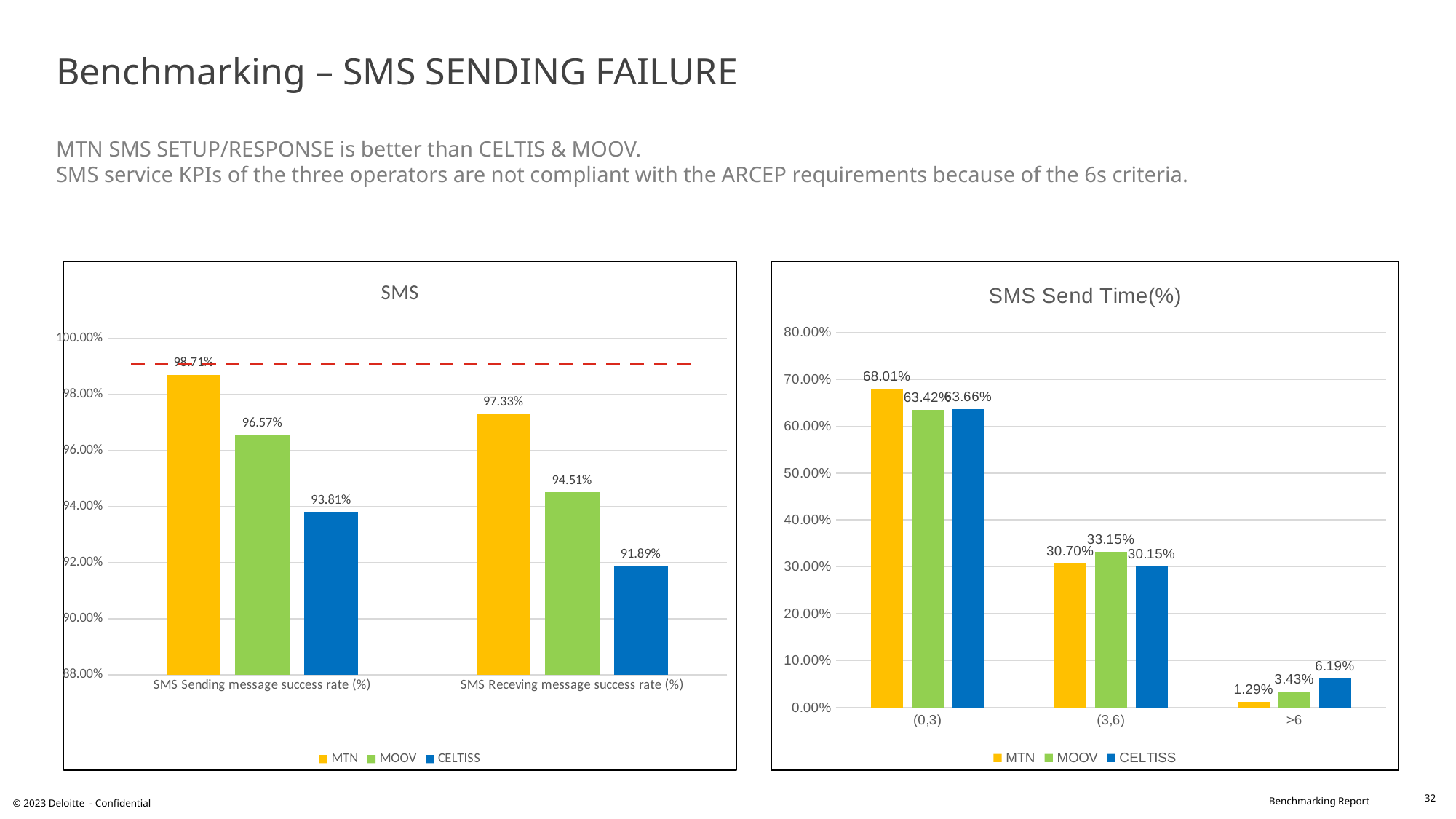
In the 'SMS Send Time(%)' chart, how many categories are shown on the x axis? 3 In the 'SMS' chart, what is the SMS Sending message success rate (%) for MTN? 98.71% In the 'SMS Send Time(%)' chart, do MTN's values rise or fall from (0,3) to >6? fall In the 'SMS' chart, which operator has the lowest SMS Sending message success rate (%)? CELTISS What kind of chart is the 'SMS Send Time(%)' chart? bar chart In the 'SMS' chart, how many series does the legend list? 3 In the 'SMS Send Time(%)' chart, which operator has the highest value in the (0,3) category? MTN In the 'SMS Send Time(%)' chart, what is the value for CELTISS in the >6 category? 6.19% In the 'SMS Send Time(%)' chart, what is the value for MOOV in the (3,6) category? 33.15% In the 'SMS' chart, what is the difference between MTN's and MOOV's SMS Receving message success rate (%)? 2.82% In the 'SMS' chart, what is the SMS Receving message success rate (%) for CELTISS? 91.89% In the 'SMS Send Time(%)' chart, which is larger in the >6 category: MTN or MOOV? MOOV